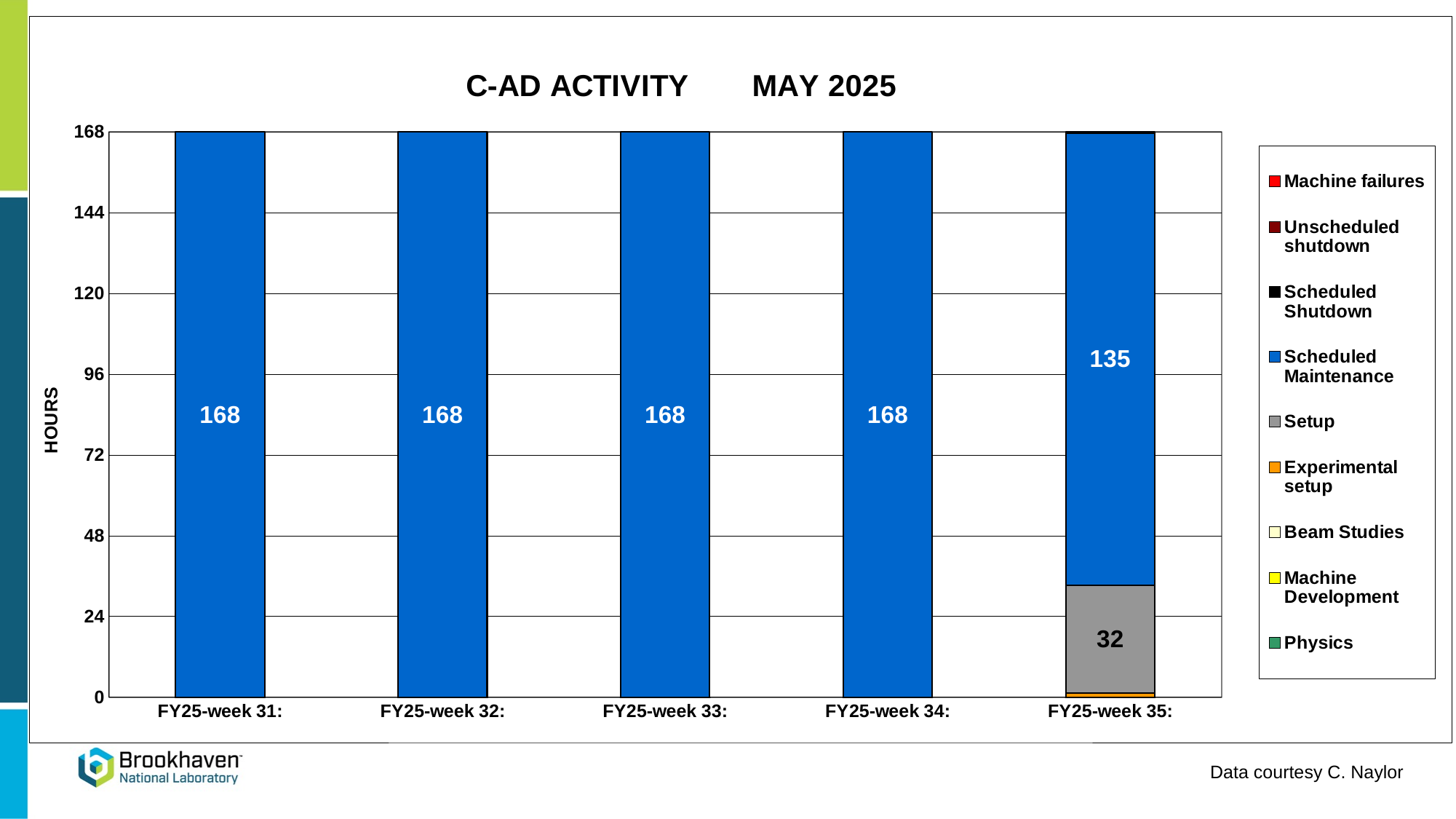
How many series does the legend list? 9 Which week has the lowest Scheduled Maintenance value? FY25-week 35 What is the Scheduled Maintenance value for FY25-week 31? 168 What is the difference between the Scheduled Maintenance values for FY25-week 34 and FY25-week 35? 33 How many weeks are shown on the x axis? 5 In FY25-week 35, which is larger: Scheduled Maintenance or Setup? Scheduled Maintenance What is the label on the y axis? HOURS Is the Scheduled Maintenance value for FY25-week 35 greater or less than 120? greater What is the Setup value for FY25-week 35? 32 In FY25-week 35, what is the difference between the Scheduled Maintenance value and the Setup value? 103 What kind of chart is shown? stacked bar chart What is the Scheduled Maintenance value for FY25-week 35? 135